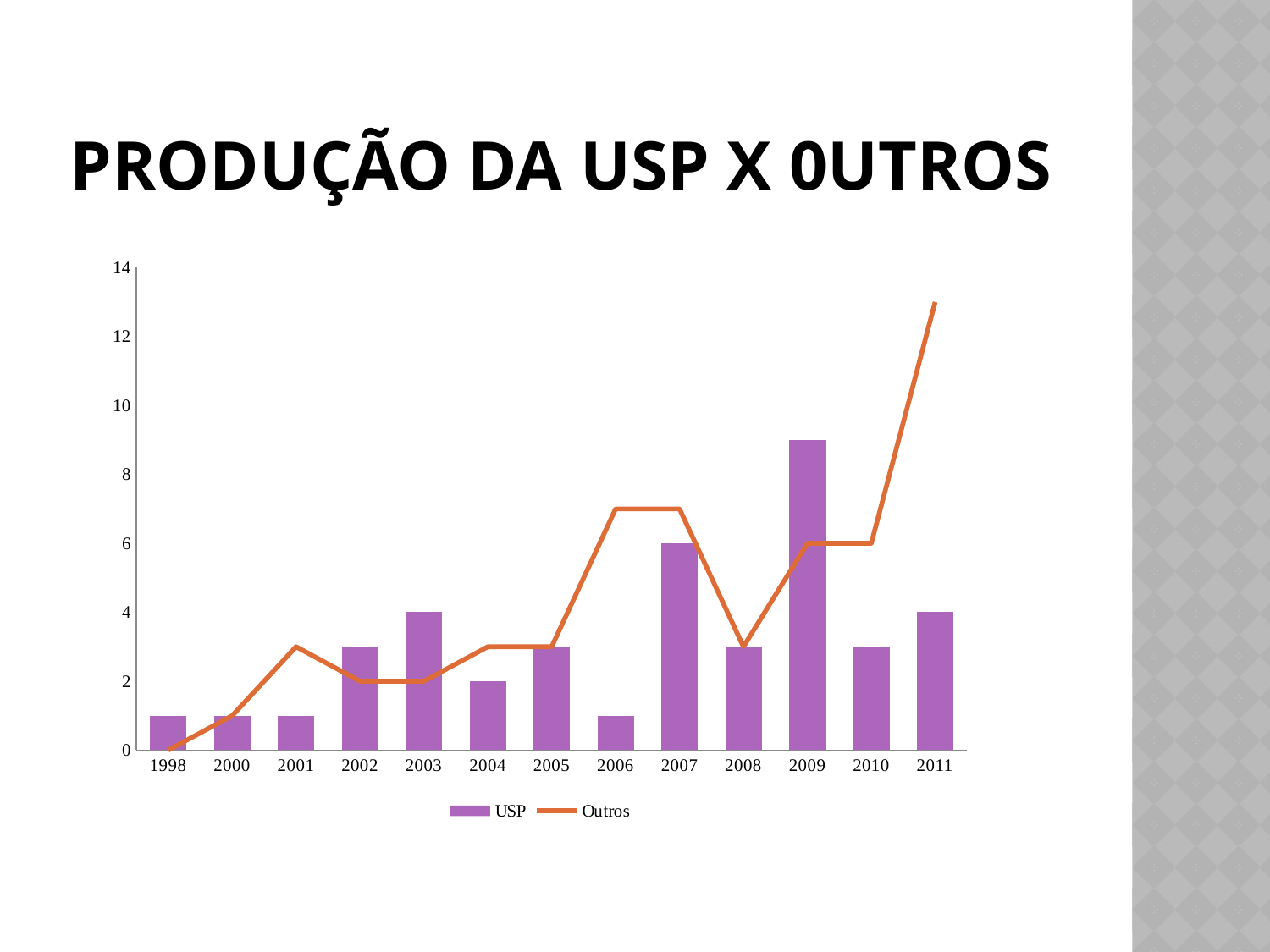
What is the Outros value for 2010? 6 In 2006, which is larger, USP or Outros? Outros In which year is the USP bar highest? 2009 How many series does the legend list? 2 What is the USP value for 2004? 2 What kind of chart is shown on the slide? A combination bar and line chart How many years are shown on the x axis? 13 What is the difference between the USP values for 2007 and 2004? 4 Is the USP value for 2009 greater or less than 8? greater In which year does the Outros line reach its highest value? 2011 Is the Outros value for 2011 greater or less than 12? greater What is the USP value for 2007? 6